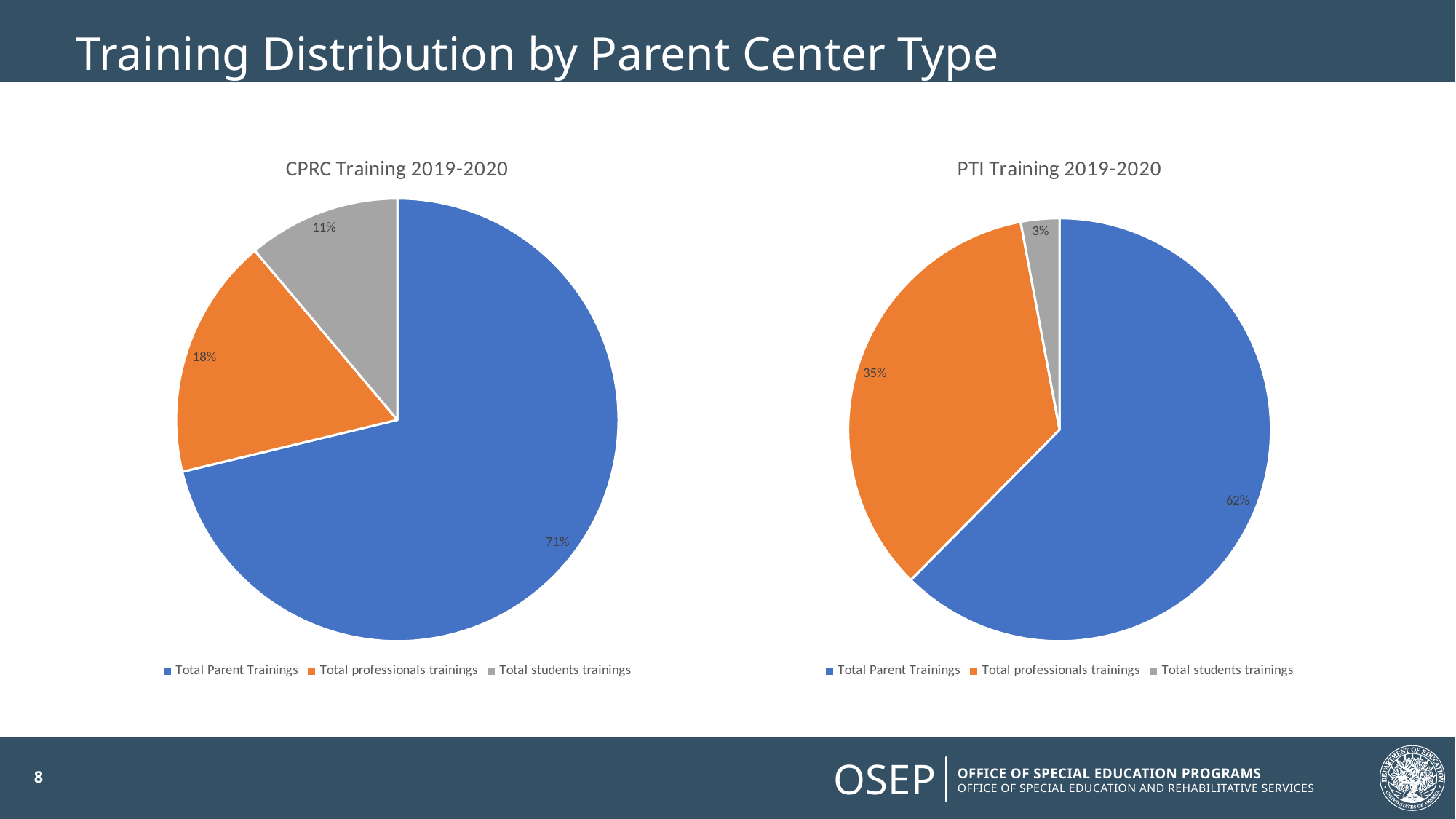
In the CPRC Training 2019-2020 chart, which category has the smallest slice? Total students trainings In the CPRC Training 2019-2020 chart, what is the difference in percentage points between Total professionals trainings and Total students trainings? 7 What type of chart is the PTI Training 2019-2020 chart? Pie chart In the PTI Training 2019-2020 chart, what share of trainings is Total professionals trainings? 35% In the PTI Training 2019-2020 chart, which category has the largest slice? Total Parent Trainings In the CPRC Training 2019-2020 chart, what share of trainings is Total Parent Trainings? 71% How many entries does the legend of the PTI Training 2019-2020 chart list? 3 In the PTI Training 2019-2020 chart, what share of trainings is Total students trainings? 3% Which chart shows a larger share for Total professionals trainings, CPRC Training 2019-2020 or PTI Training 2019-2020? PTI Training 2019-2020 In the CPRC Training 2019-2020 chart, what colour is the Total professionals trainings slice? Orange What is the title of the chart on the left side of the slide? CPRC Training 2019-2020 How many slices does the CPRC Training 2019-2020 chart have? 3